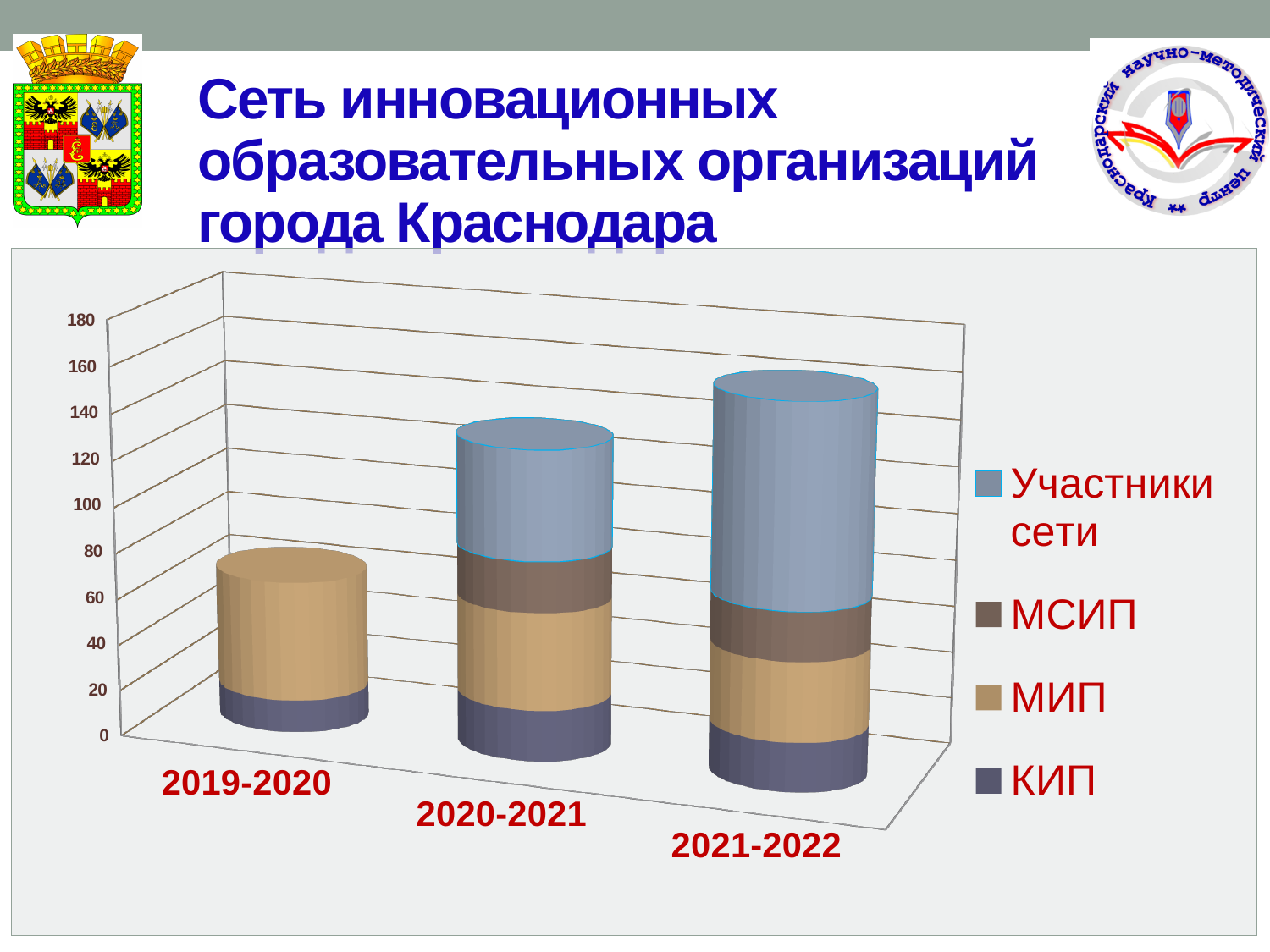
Which legend entry is shown in light blue? Участники сети Do the total bar heights rise or fall from 2019-2020 to 2021-2022? Rise How many categories (academic years) are shown on the x axis? 3 How many series does the legend list? 4 Is the total value for 2021-2022 greater or less than 100? greater Is the total value for 2020-2021 greater or less than 80? greater Which total is larger, 2020-2021 or 2019-2020? 2020-2021 What kind of chart is shown on the slide? Stacked bar chart Which series is shown at the bottom of each stacked bar? КИП Which academic year has the highest total bar? 2021-2022 Which academic year has the lowest total bar? 2019-2020 Is the total value for 2019-2020 greater or less than 100? less